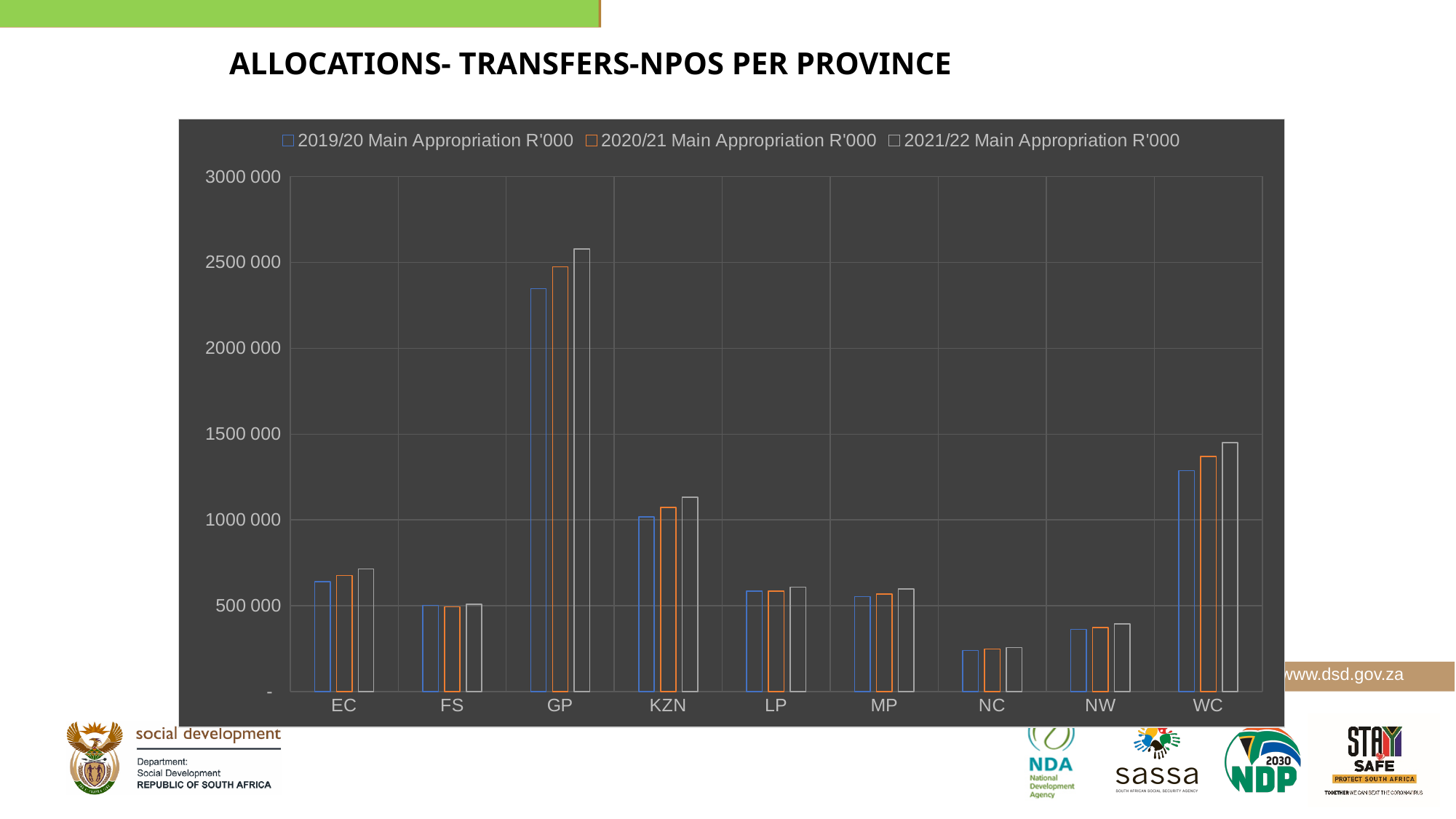
How many series does the chart legend list? 3 Which province has the lowest 2019/20 Main Appropriation? NC Is the 2019/20 Main Appropriation for WC greater or less than 1500 000? less Is the 2021/22 Main Appropriation for KZN greater or less than 1000 000? greater Which province has the highest 2021/22 Main Appropriation? GP Is the 2021/22 Main Appropriation for NC greater or less than 500 000? less How many provinces are shown on the x axis of the chart? 9 Which province has the larger 2019/20 Main Appropriation, EC or FS? EC Which province has the larger 2021/22 Main Appropriation, KZN or WC? WC Do the Main Appropriation values for GP rise or fall from 2019/20 to 2021/22? rise What kind of chart is shown on the slide? bar chart